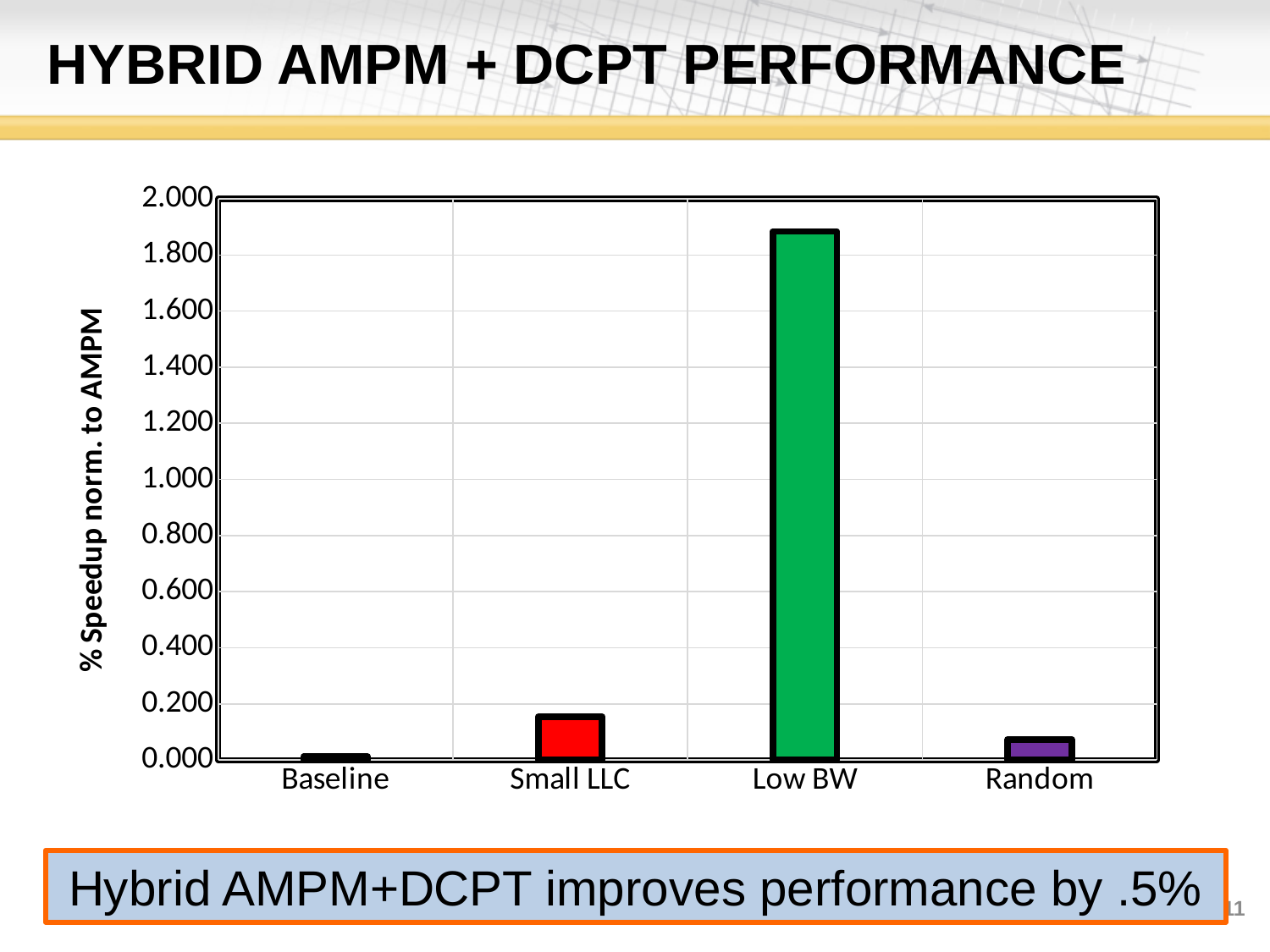
What kind of chart is shown on the slide? bar chart Which category has the lowest value in the chart? Baseline Is the value for Random greater or less than 0.200? less Is the value for Small LLC greater or less than 0.200? less Is the value for Low BW greater or less than 1.800? greater Which is larger, the value for Low BW or the value for Small LLC? Low BW Which category has the highest value in the chart? Low BW What is the label of the y axis of the chart? % Speedup norm. to AMPM Which is larger, the value for Small LLC or the value for Random? Small LLC What colour is the bar for Low BW? green How many categories are shown on the x axis of the chart? 4